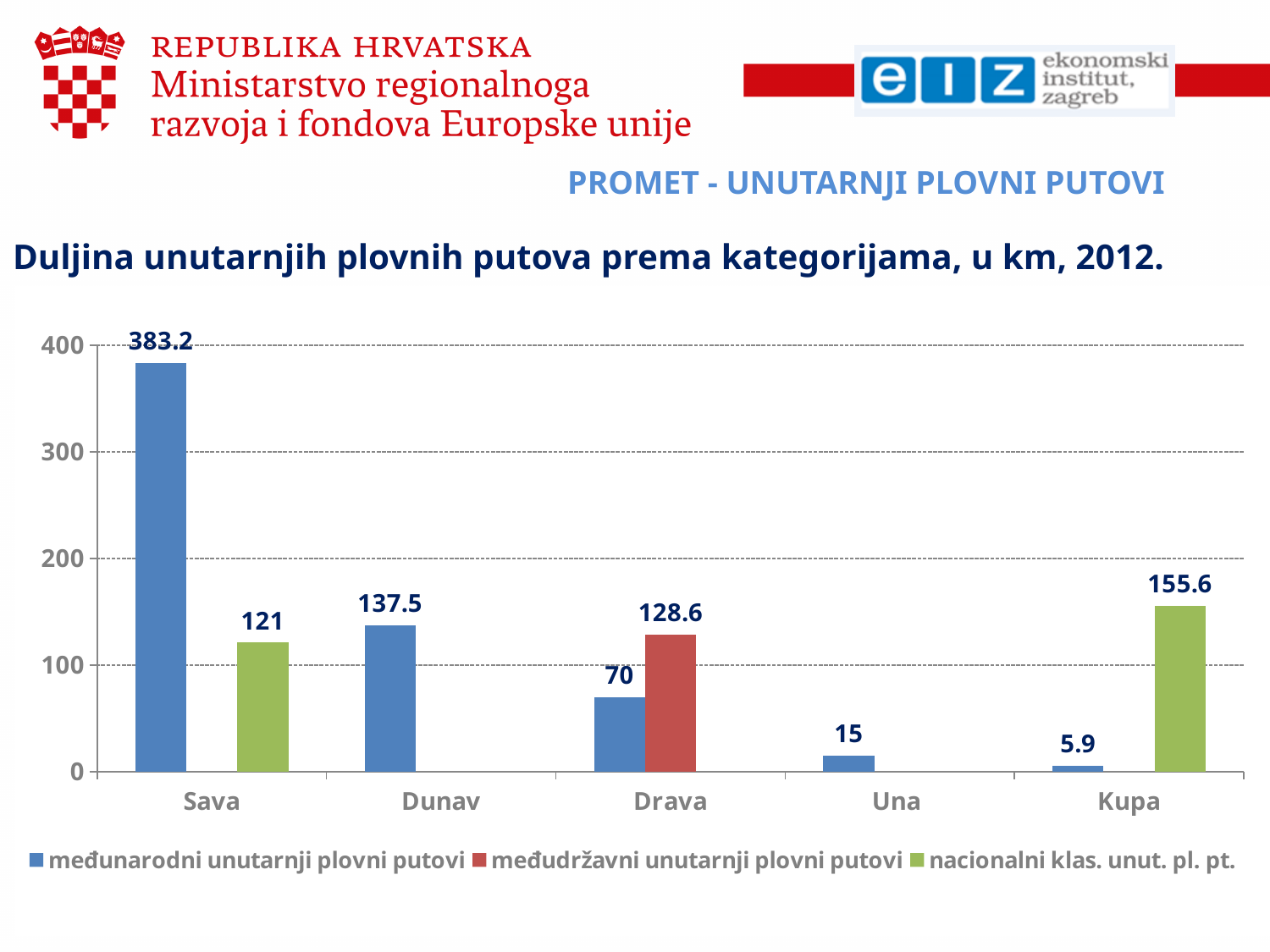
What is the value for Sava in the 'međunarodni unutarnji plovni putovi' series? 383.2 What is the value for Drava in the 'međudržavni unutarnji plovni putovi' series? 128.6 Which river has the highest value in the 'međunarodni unutarnji plovni putovi' series? Sava Which river has the lowest value in the 'međunarodni unutarnji plovni putovi' series? Kupa What is the title of the chart? Duljina unutarnjih plovnih putova prema kategorijama, u km, 2012. Is the 'nacionalni klas. unut. pl. pt.' value for Kupa greater or less than 100? greater How many rivers are shown on the x axis? 5 What is the value for Kupa in the 'nacionalni klas. unut. pl. pt.' series? 155.6 Which is larger: the 'međunarodni unutarnji plovni putovi' value for Dunav or the 'međudržavni unutarnji plovni putovi' value for Drava? Dunav (137.5) What kind of chart is shown on the slide? bar chart How many series does the legend list? 3 What is the difference between the 'međunarodni unutarnji plovni putovi' value for Sava and the 'nacionalni klas. unut. pl. pt.' value for Sava? 262.2